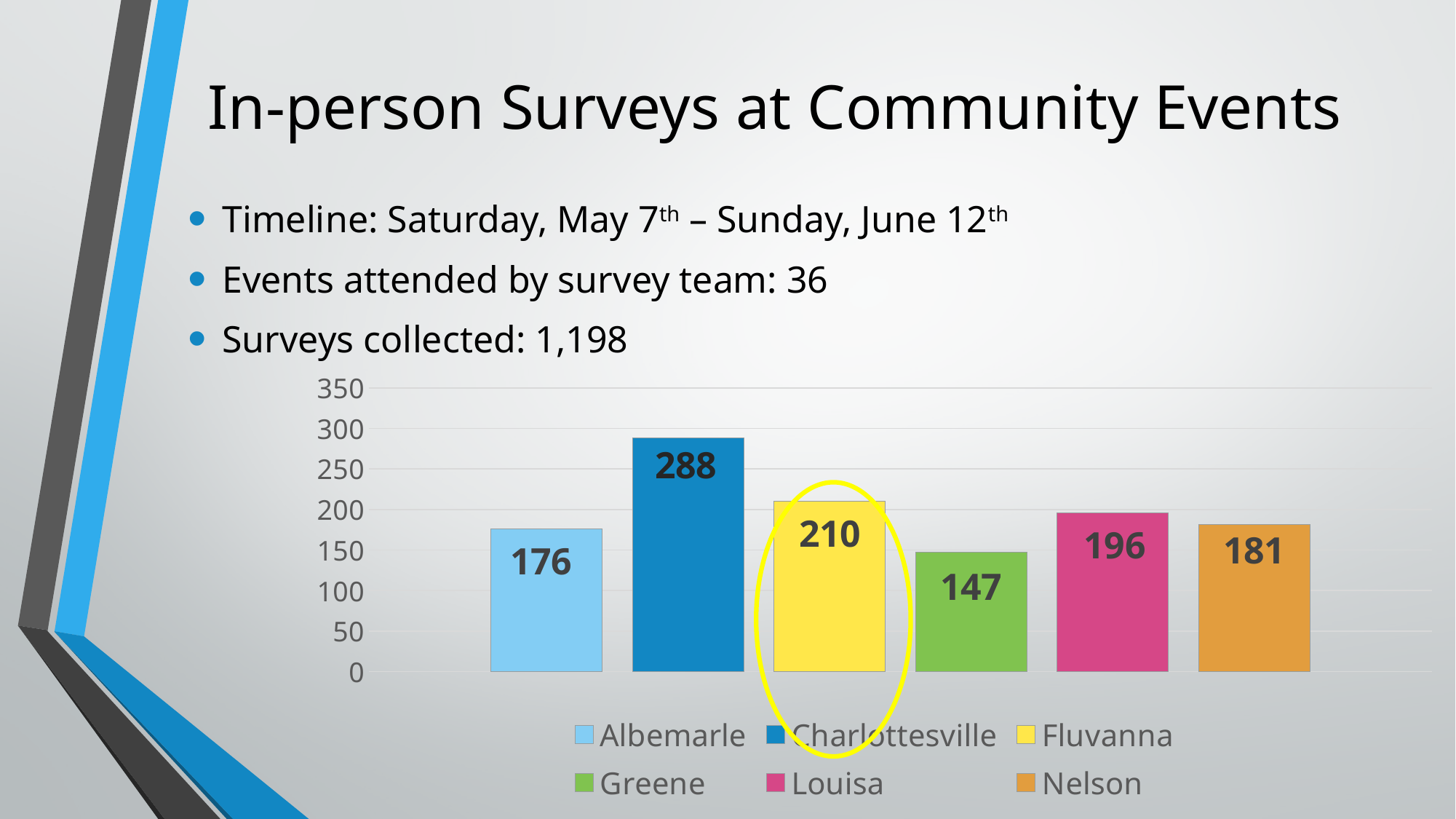
Which bar is circled in yellow on the chart? Fluvanna Which locality has the highest bar? Charlottesville Is the value for Nelson greater or less than 200? less What is the difference between the values for Louisa and Nelson? 15 What is the value shown for Fluvanna? 210 What kind of chart is shown on the slide? bar chart Which locality has the lowest bar? Greene How many surveys were collected in Charlottesville? 288 What is the value shown for Greene? 147 How many localities are shown in the chart? 6 What is the difference between the values for Charlottesville and Albemarle? 112 Which is larger, the value for Fluvanna or the value for Louisa? Fluvanna